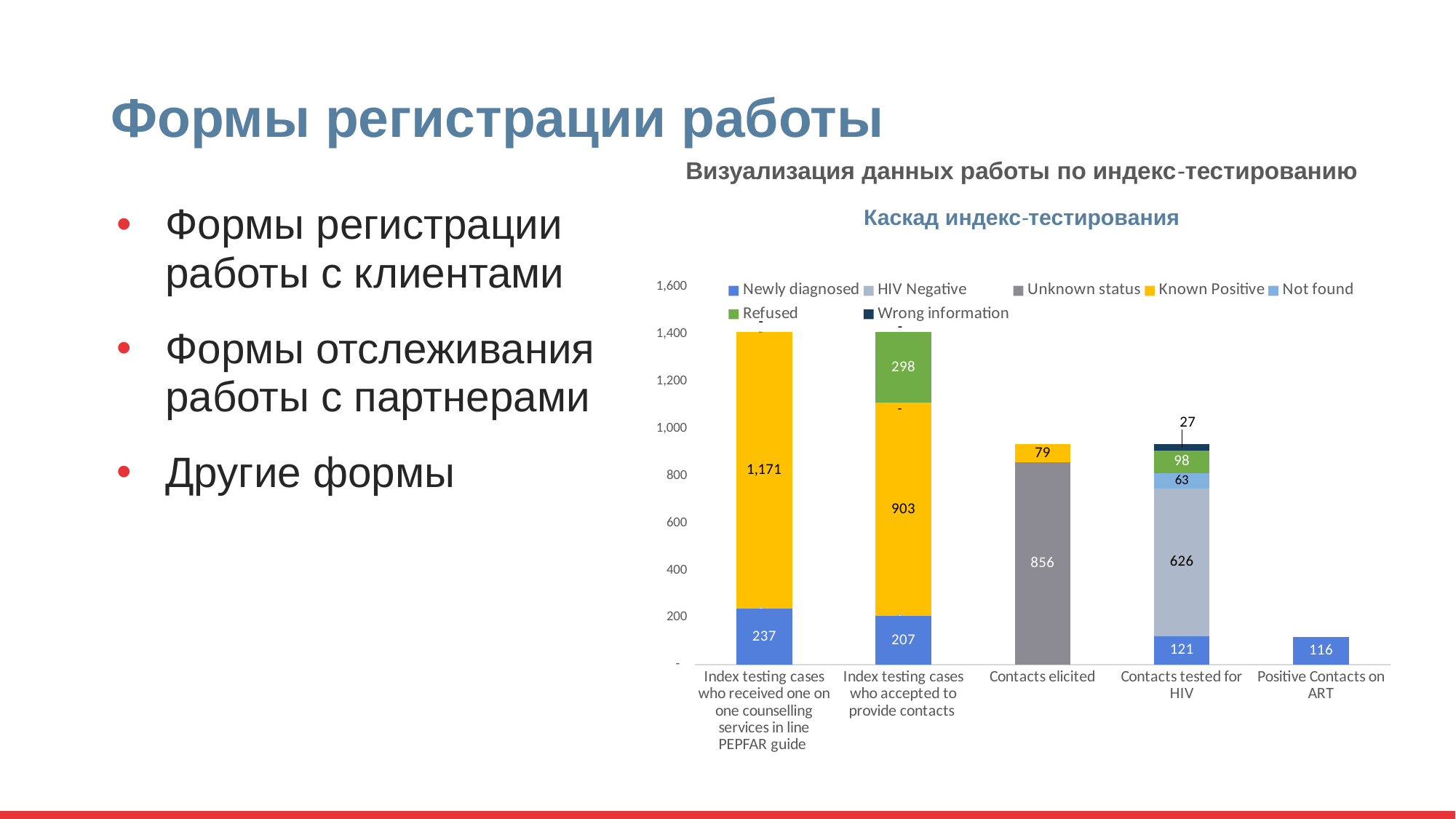
What is the Newly diagnosed value for "Positive Contacts on ART"? 116 What is the difference between the Newly diagnosed values for "Index testing cases who received one on one counselling services in line PEPFAR guide" and "Index testing cases who accepted to provide contacts"? 30 What is the Wrong information value for "Contacts tested for HIV"? 27 What is the total of the stacked bar for "Contacts elicited"? 935 How many series does the legend of the chart list? 7 What kind of chart is shown under the title "Каскад индекс-тестирования"? stacked bar chart What is the Known Positive value for "Index testing cases who received one on one counselling services in line PEPFAR guide"? 1,171 Which is larger: the Known Positive value for "Index testing cases who accepted to provide contacts" or the Unknown status value for "Contacts elicited"? Known Positive for Index testing cases who accepted to provide contacts (903) How many categories are shown along the x axis of the chart? 5 What is the HIV Negative value for "Contacts tested for HIV"? 626 What is the Refused value for "Index testing cases who accepted to provide contacts"? 298 What is the Unknown status value for "Contacts elicited"? 856